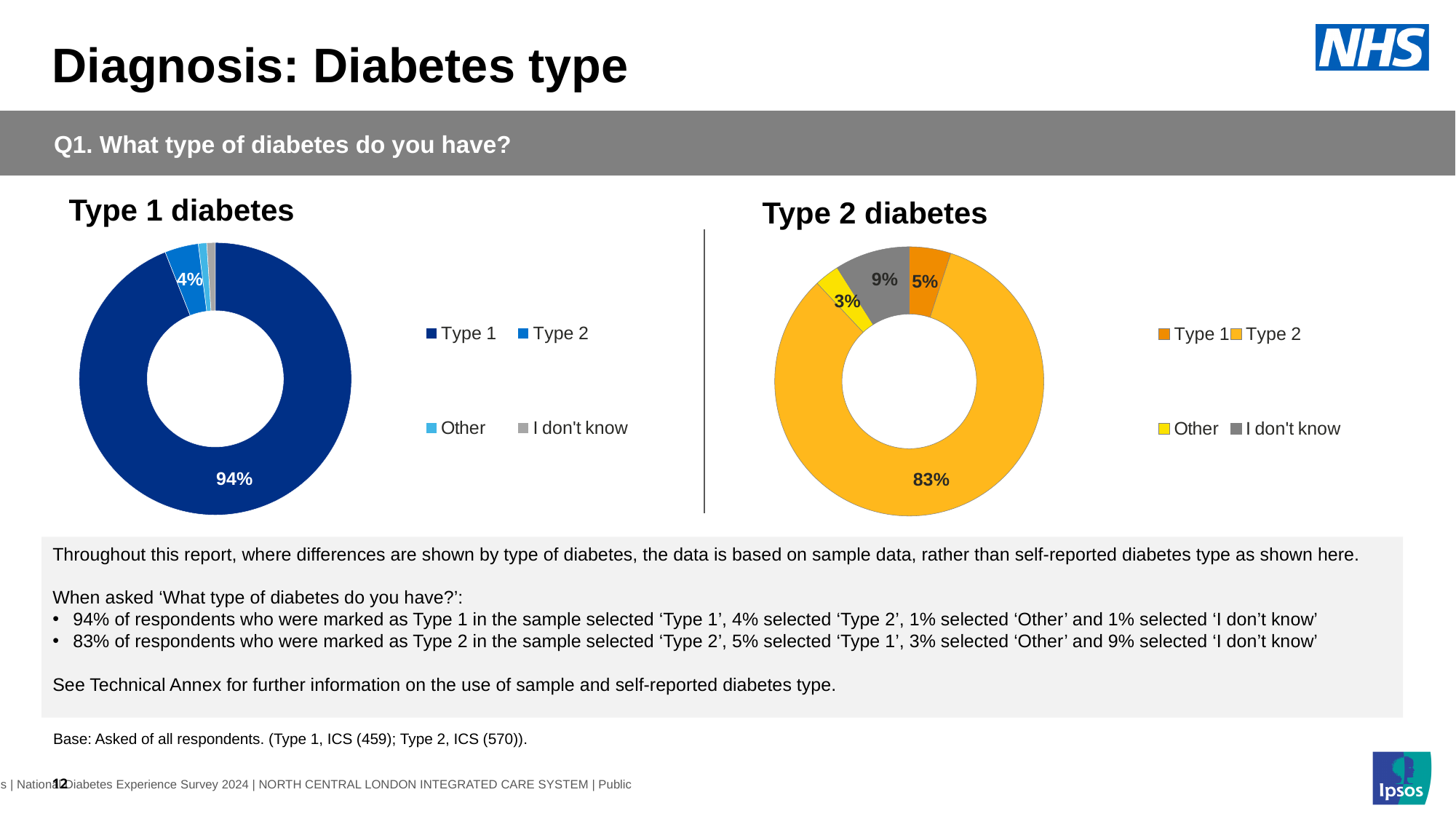
In the Type 2 diabetes chart, what is the difference between the 'I don't know' share and the 'Type 1' share? 4% In the Type 1 diabetes chart, which category has the largest share? Type 1 In the Type 2 diabetes chart, what percentage selected 'Type 1'? 5% In the Type 2 diabetes chart, what percentage selected 'Other'? 3% How many categories does the legend of the Type 2 diabetes chart list? 4 In the Type 2 diabetes chart, what percentage selected 'I don't know'? 9% In the Type 2 diabetes chart, what percentage selected 'Type 2'? 83% In the Type 2 diabetes chart, which is larger: the 'I don't know' share or the 'Other' share? I don't know In the Type 2 diabetes chart, which category has the largest share? Type 2 In the Type 1 diabetes chart, what percentage selected 'Type 2'? 4% In the Type 1 diabetes chart, what percentage selected 'Type 1'? 94% What kind of chart is used for the Type 1 diabetes data? Doughnut (pie) chart